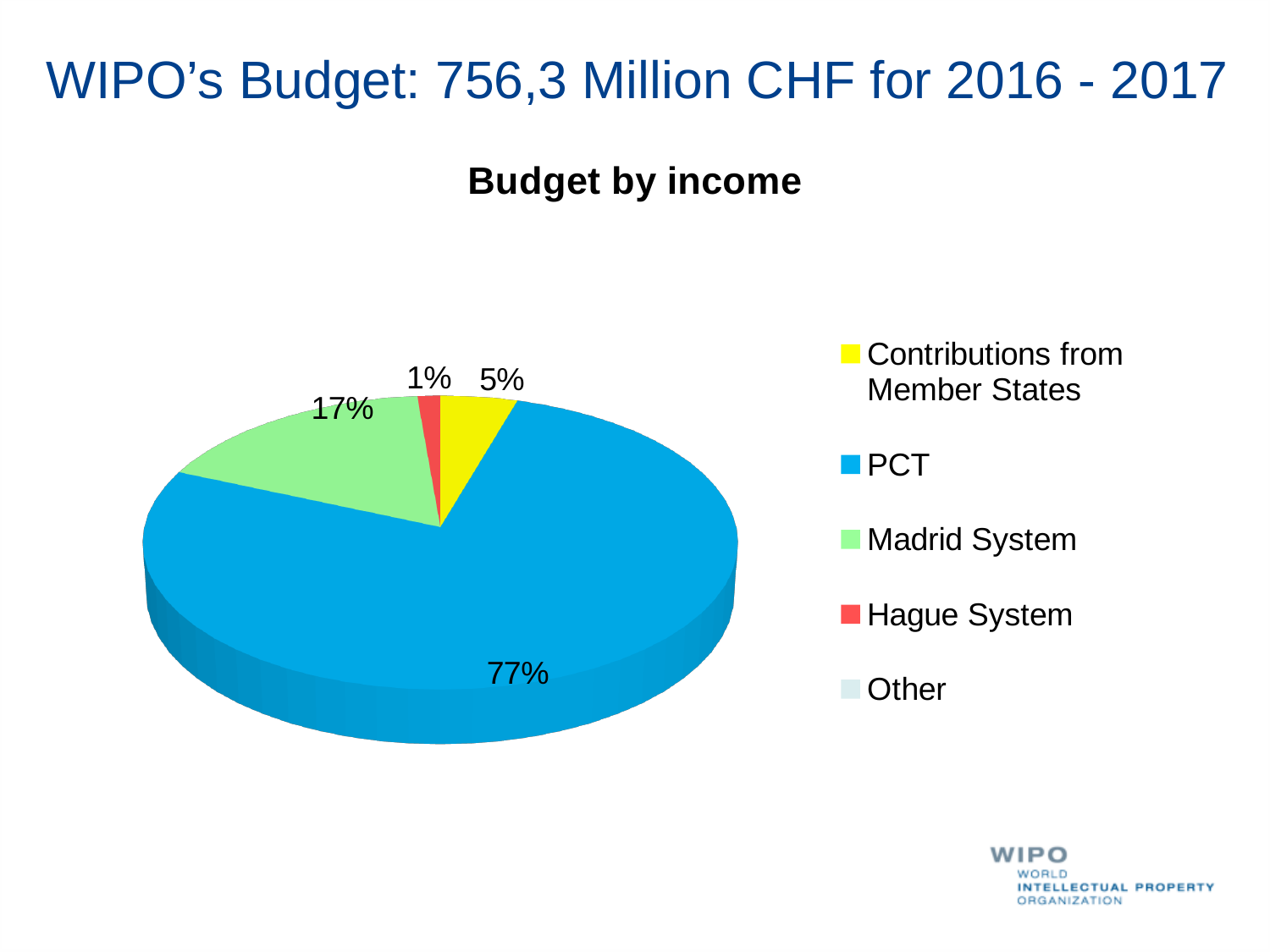
What percentage of the budget by income is from the Madrid System? 17% Which is larger: the share from Contributions from Member States or the share from the Hague System? Contributions from Member States What is the difference in percentage points between the Madrid System share and the Contributions from Member States share? 12 What percentage of the budget by income is from the Hague System? 1% What share of the budget by income comes from PCT? 77% Which income source has the largest share of the budget? PCT What is the title of the chart on the slide? Budget by income What share of the budget by income comes from Contributions from Member States? 5% How many percentage points larger is the PCT share than the Madrid System share? 60 What kind of chart is shown on the slide? Pie chart Which labelled income source has the smallest share of the budget? Hague System How many entries does the legend of the pie chart list? 5